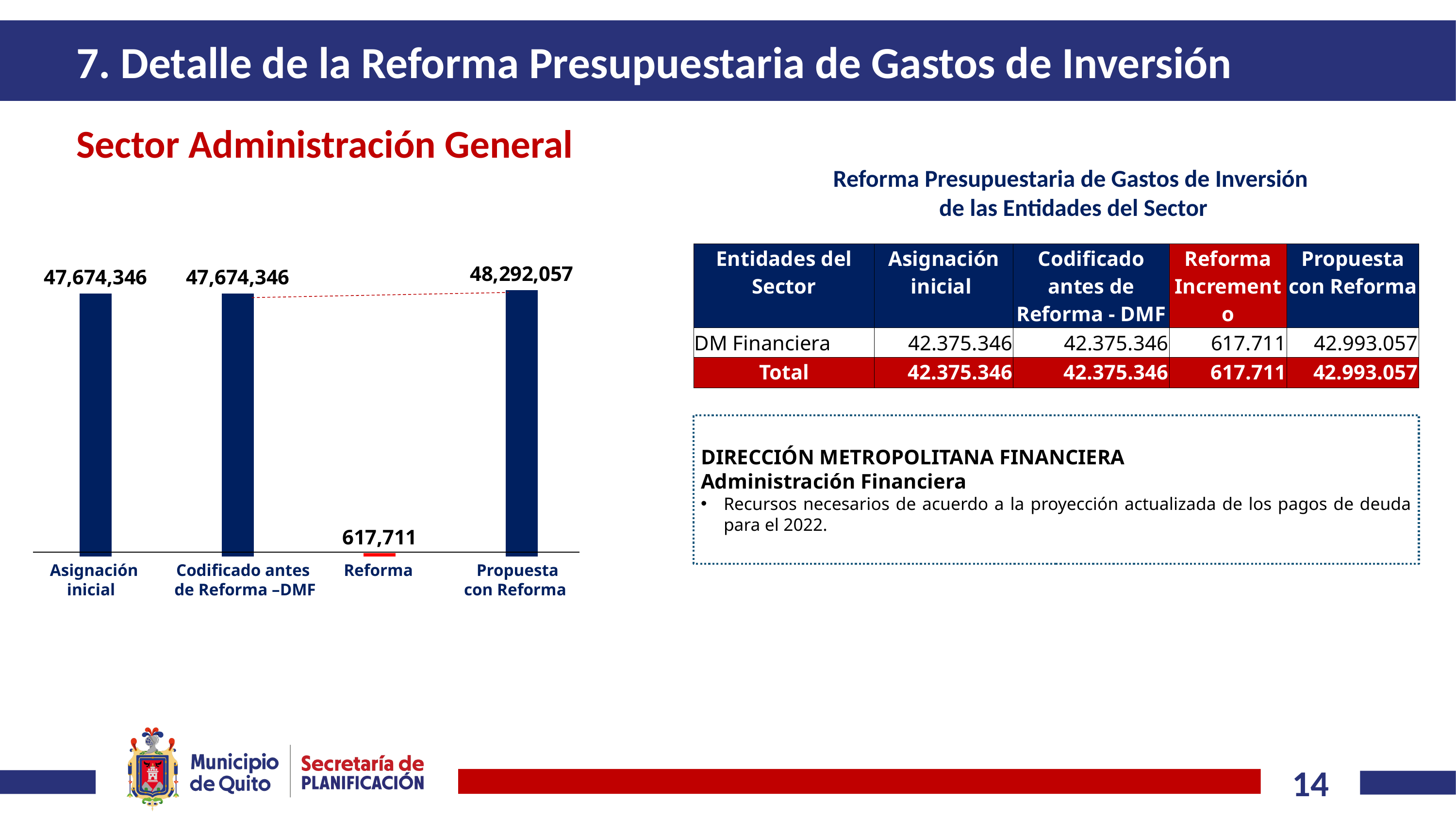
What is the value of the Asignación inicial bar in the chart? 47,674,346 What is the difference between the Propuesta con Reforma value and the Codificado antes de Reforma –DMF value in the chart? 617,711 How many bars are plotted in the chart? 4 Which category has the lowest value in the chart? Reforma What is the value of the Propuesta con Reforma bar in the chart? 48,292,057 What type of chart is shown on the slide? Bar chart What is the value of the Reforma bar in the chart? 617,711 Which bar in the chart is coloured red rather than dark blue? Reforma Do the Asignación inicial and Codificado antes de Reforma –DMF bars have the same value in the chart? Yes Which is larger in the chart: Propuesta con Reforma or Asignación inicial? Propuesta con Reforma Which category has the highest value in the chart? Propuesta con Reforma What is the value of the Codificado antes de Reforma –DMF bar in the chart? 47,674,346